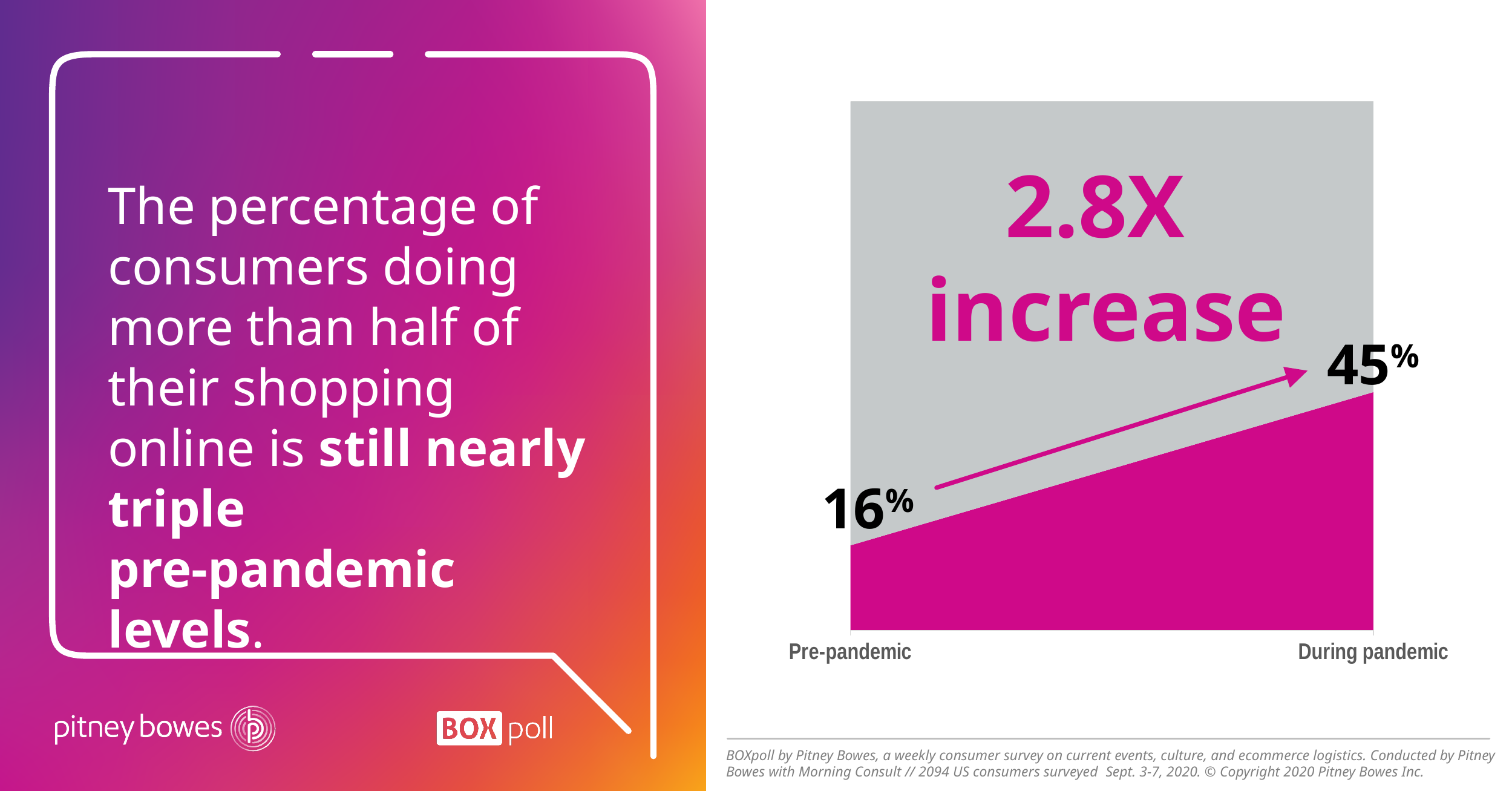
What colour is the filled area of the chart? magenta Which category has the higher value, Pre-pandemic or During pandemic? During pandemic How many categories are shown on the x axis of the chart? 2 What is the value for Pre-pandemic? 16% What is the difference between the During pandemic value and the Pre-pandemic value? 29% What kind of chart is shown on the slide? area chart Which category has the lowest value? Pre-pandemic What is the value for During pandemic? 45% Which category has the highest value? During pandemic What multiplier of increase is printed on the chart? 2.8X Do the values rise or fall from Pre-pandemic to During pandemic? rise